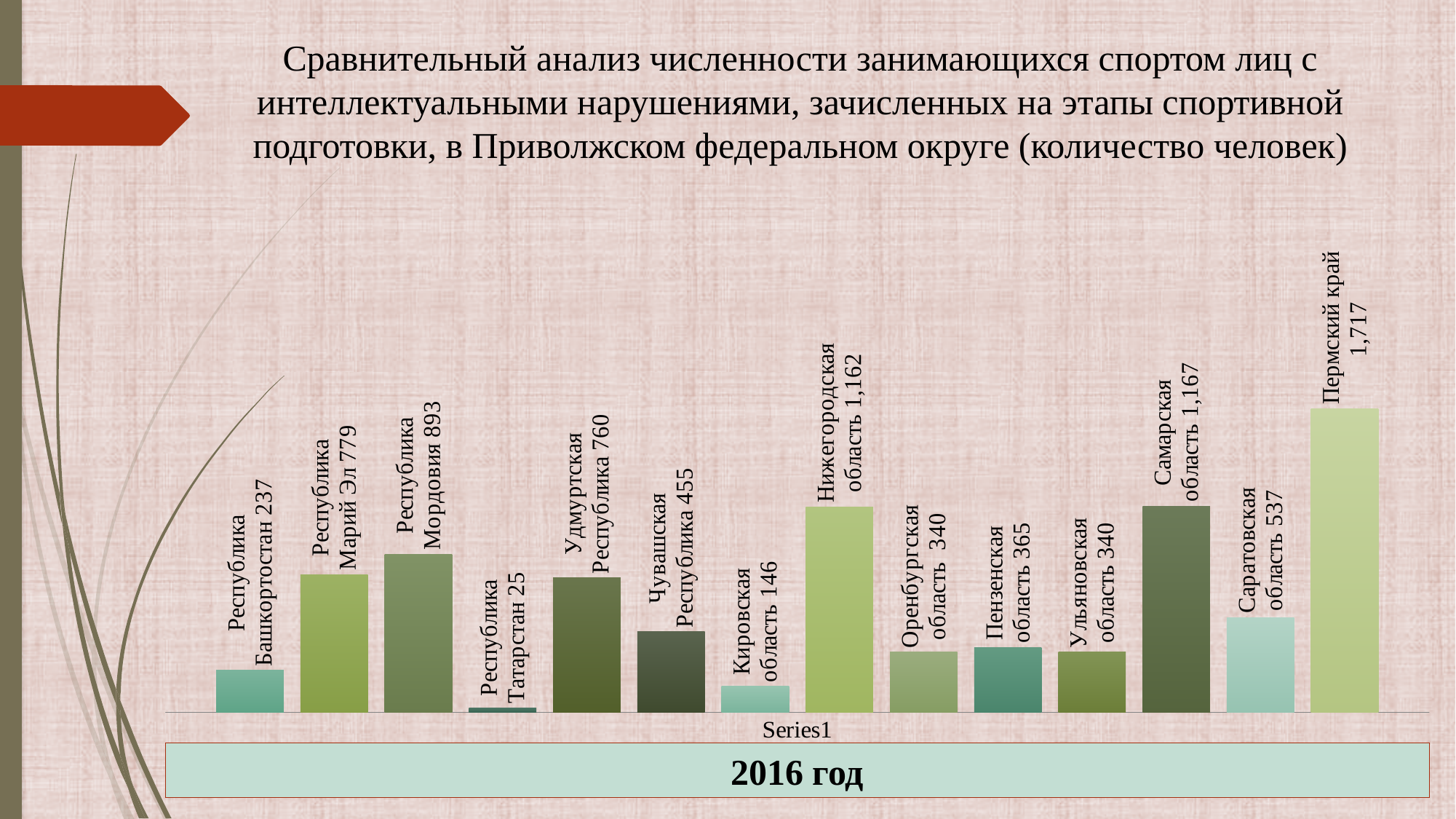
How many regions are shown in the chart? 14 Which region has the highest value? Пермский край What is the value for Саратовская область? 537 Which region has the lowest value? Республика Татарстан What is the value for Республика Татарстан? 25 Which year does the chart refer to, according to the label below it? 2016 год What kind of chart is shown on the slide? Bar chart What is the value for Пермский край? 1,717 What is the difference between the values for Республика Мордовия and Республика Марий Эл? 114 What is the difference between the values for Пермский край and Самарская область? 550 What is the value for Нижегородская область? 1,162 Which is larger, the value for Республика Мордовия or Удмуртская Республика? Республика Мордовия